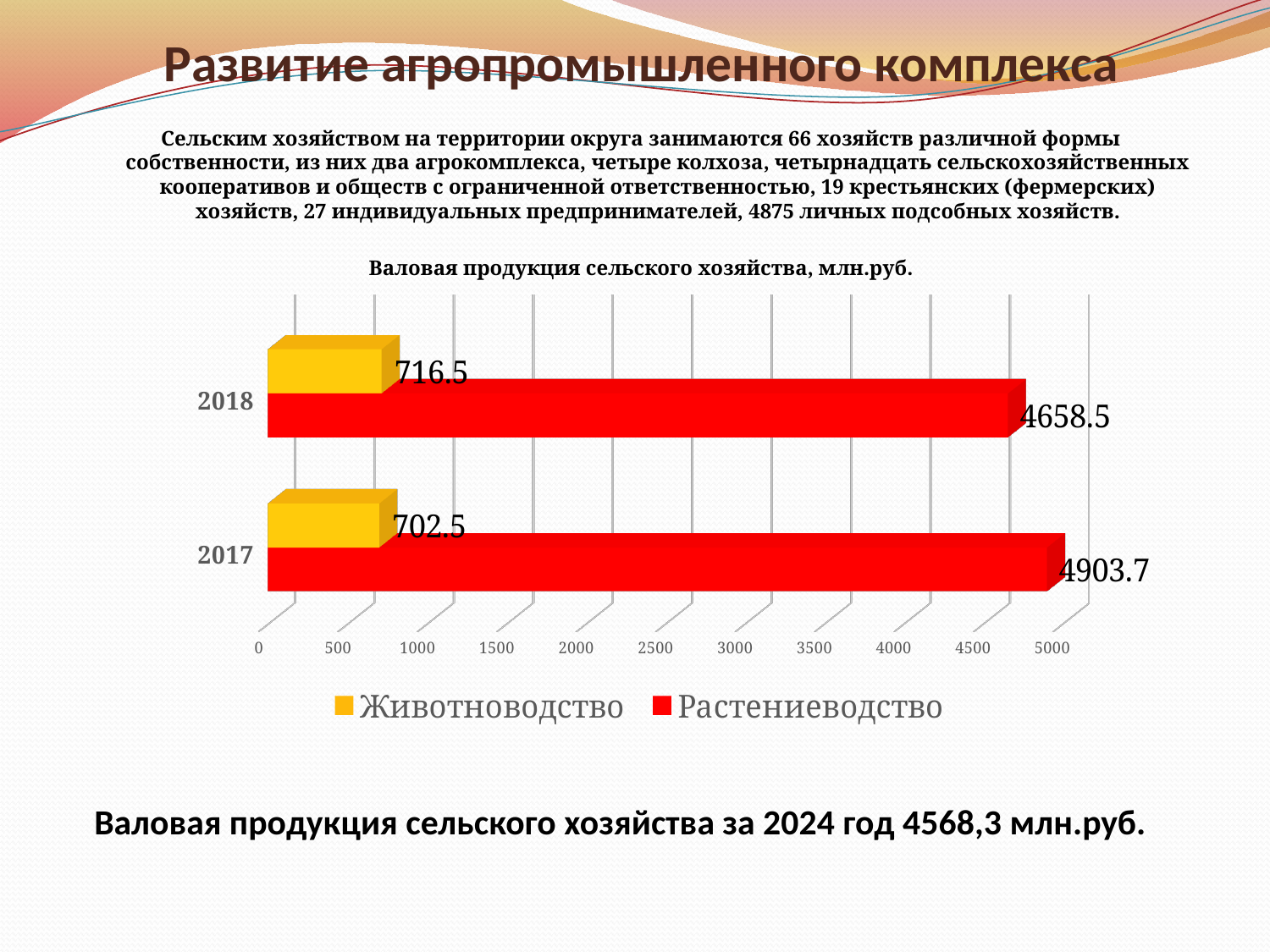
What is the value for Животноводство in 2017? 702.5 What is the value for Животноводство in 2018? 716.5 What is the title of the chart? Валовая продукция сельского хозяйства, млн.руб. What is the difference between the Животноводство values for 2018 and 2017? 14.0 What is the difference between the Растениеводство values for 2017 and 2018? 245.2 How many series does the legend list? 2 Which is larger in 2018: Животноводство or Растениеводство? Растениеводство What kind of chart is shown on the slide? Bar chart In which year is the value for Растениеводство highest? 2017 In which year is the value for Животноводство lowest? 2017 What is the value for Растениеводство in 2018? 4658.5 What is the value for Растениеводство in 2017? 4903.7